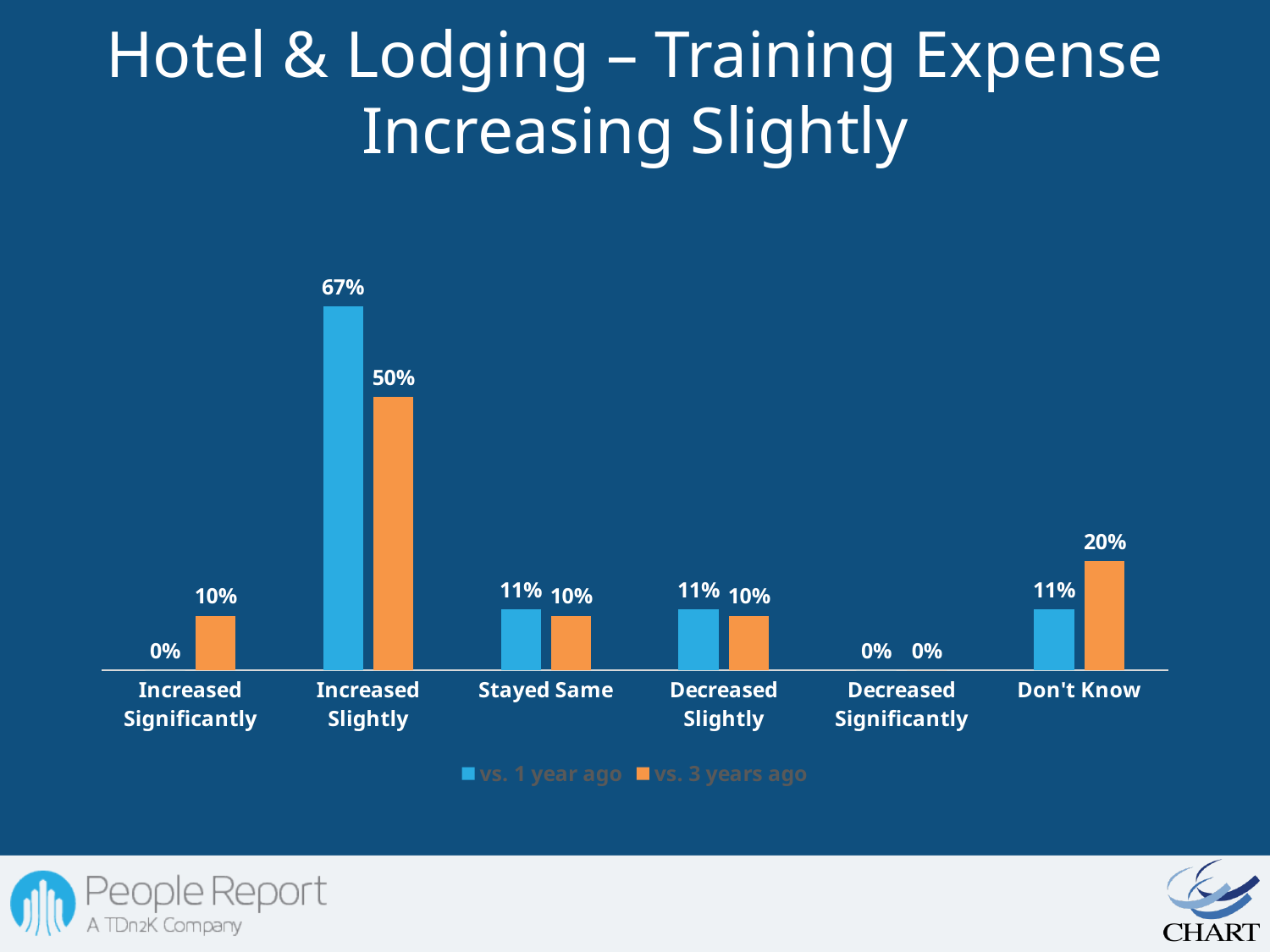
What is the difference between the "vs. 3 years ago" values for "Don't Know" and "Decreased Slightly"? 10% What is the value for "Don't Know" in the "vs. 3 years ago" series? 20% What is the value for "Increased Slightly" in the "vs. 1 year ago" series? 67% Which category has the highest value in the "vs. 3 years ago" series? Increased Slightly What is the value for "Increased Significantly" in the "vs. 1 year ago" series? 0% What kind of chart is shown on the slide? Bar chart For "Don't Know", which series has the larger value, "vs. 1 year ago" or "vs. 3 years ago"? vs. 3 years ago What is the difference between the "vs. 1 year ago" and "vs. 3 years ago" values for "Increased Slightly"? 17% Which colour represents the "vs. 1 year ago" series? Blue How many categories are shown on the x axis? 6 What is the value for "Stayed Same" in the "vs. 3 years ago" series? 10% How many series does the legend list? 2